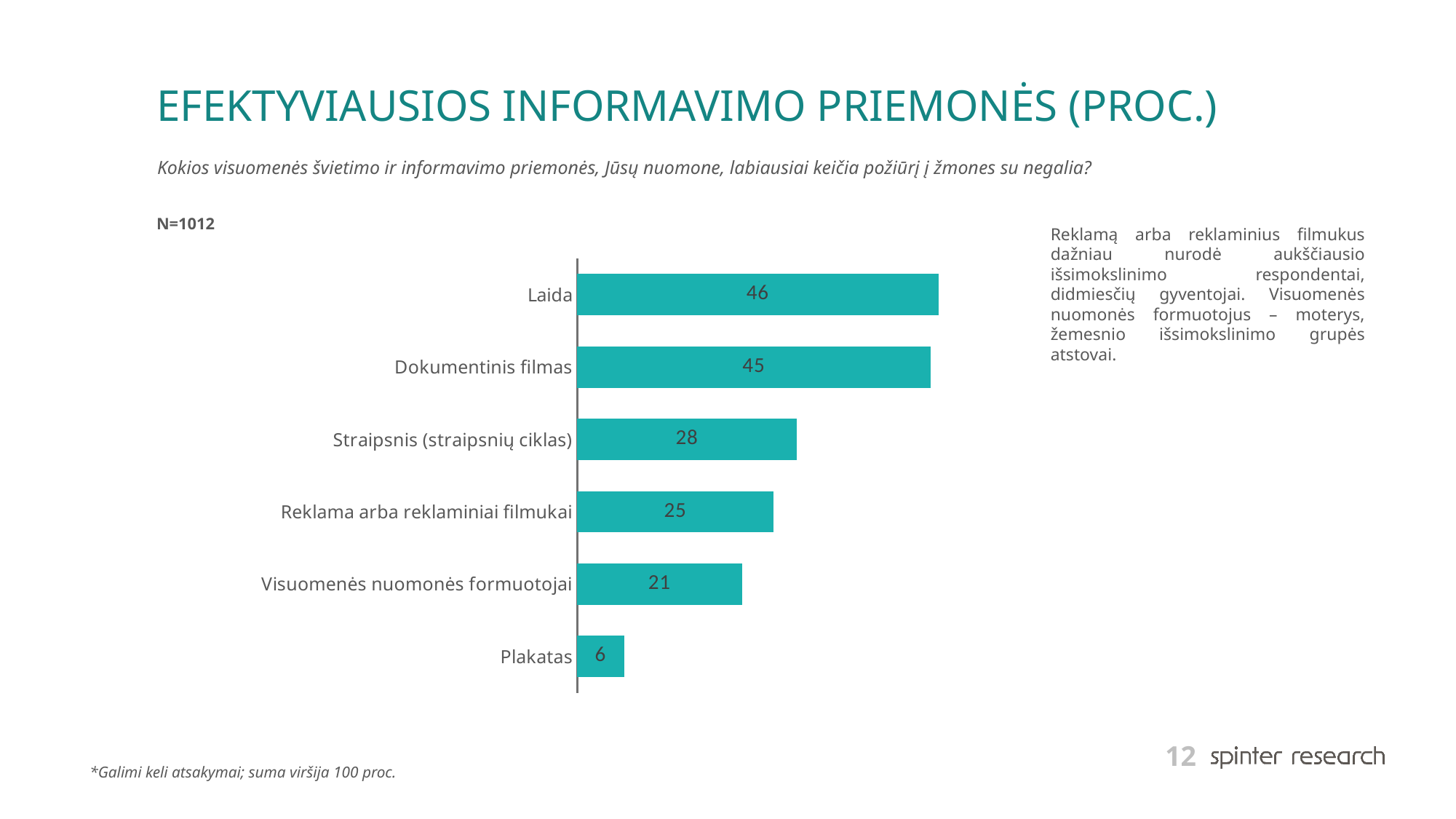
What is the value for Straipsnis (straipsnių ciklas)? 28 What is the sample size (N) stated on the slide? N=1012 What is the value for Visuomenės nuomonės formuotojai? 21 Which category has the lowest value? Plakatas What is the value for Dokumentinis filmas? 45 How many categories are shown in the chart? 6 Which category has the highest value? Laida What is the value for Laida? 46 Which is larger, the value for Reklama arba reklaminiai filmukai or the value for Visuomenės nuomonės formuotojai? Reklama arba reklaminiai filmukai What is the difference between the values for Straipsnis (straipsnių ciklas) and Reklama arba reklaminiai filmukai? 3 What kind of chart is shown on the slide? Bar chart What is the difference between the values for Laida and Plakatas? 40